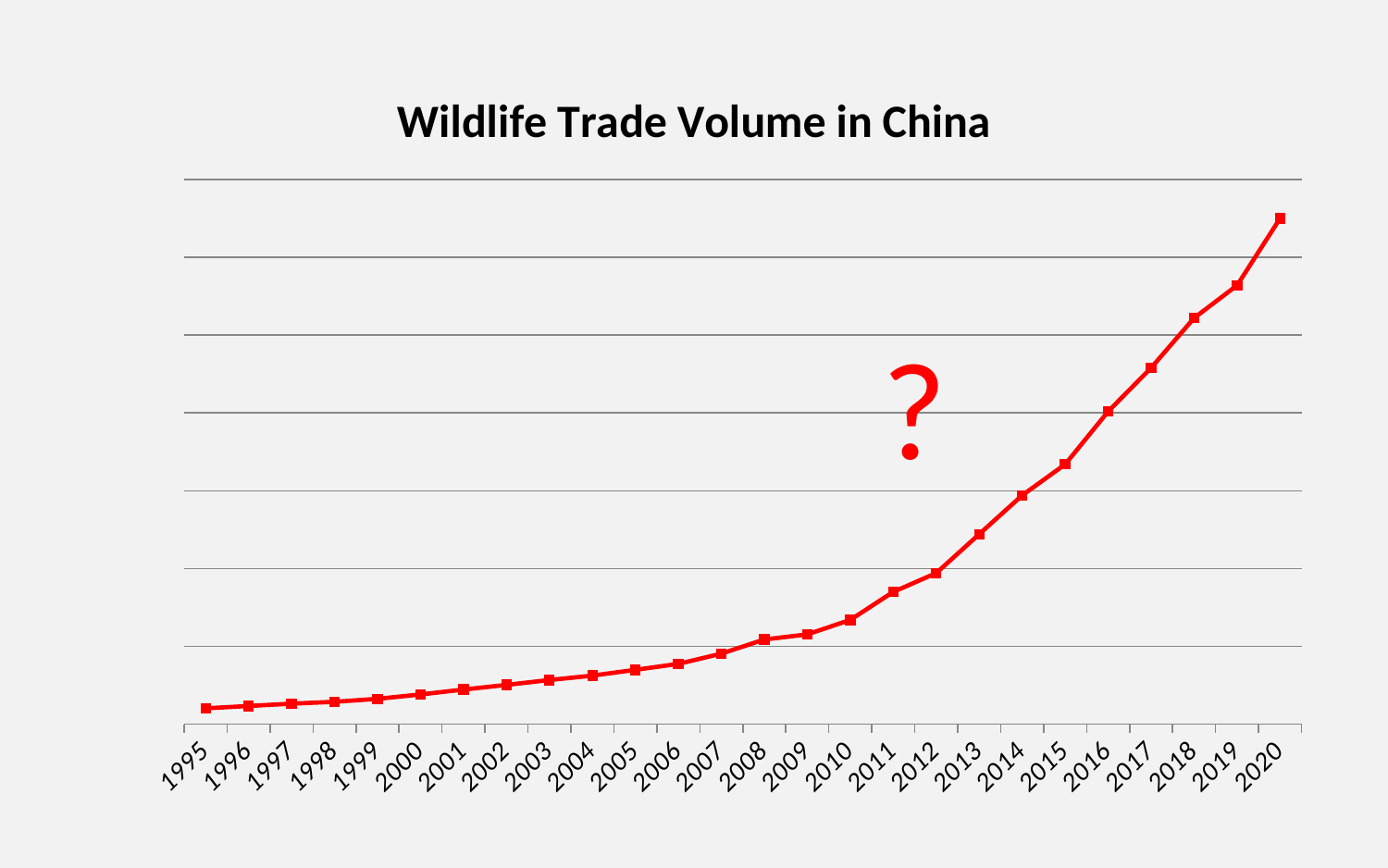
Which year has the larger value, 2005 or 2012? 2012 What kind of chart is shown on the slide? line chart Which year has the highest wildlife trade volume in the chart? 2020 Do the values rise or fall from 1995 to 2020? rise How many years are plotted on the x axis? 26 Which year has the lowest wildlife trade volume in the chart? 1995 Which year has the larger value, 2000 or 2015? 2015 Which year has the larger value, 2010 or 2018? 2018 What is the title of the chart? Wildlife Trade Volume in China What is the first year shown on the x axis? 1995